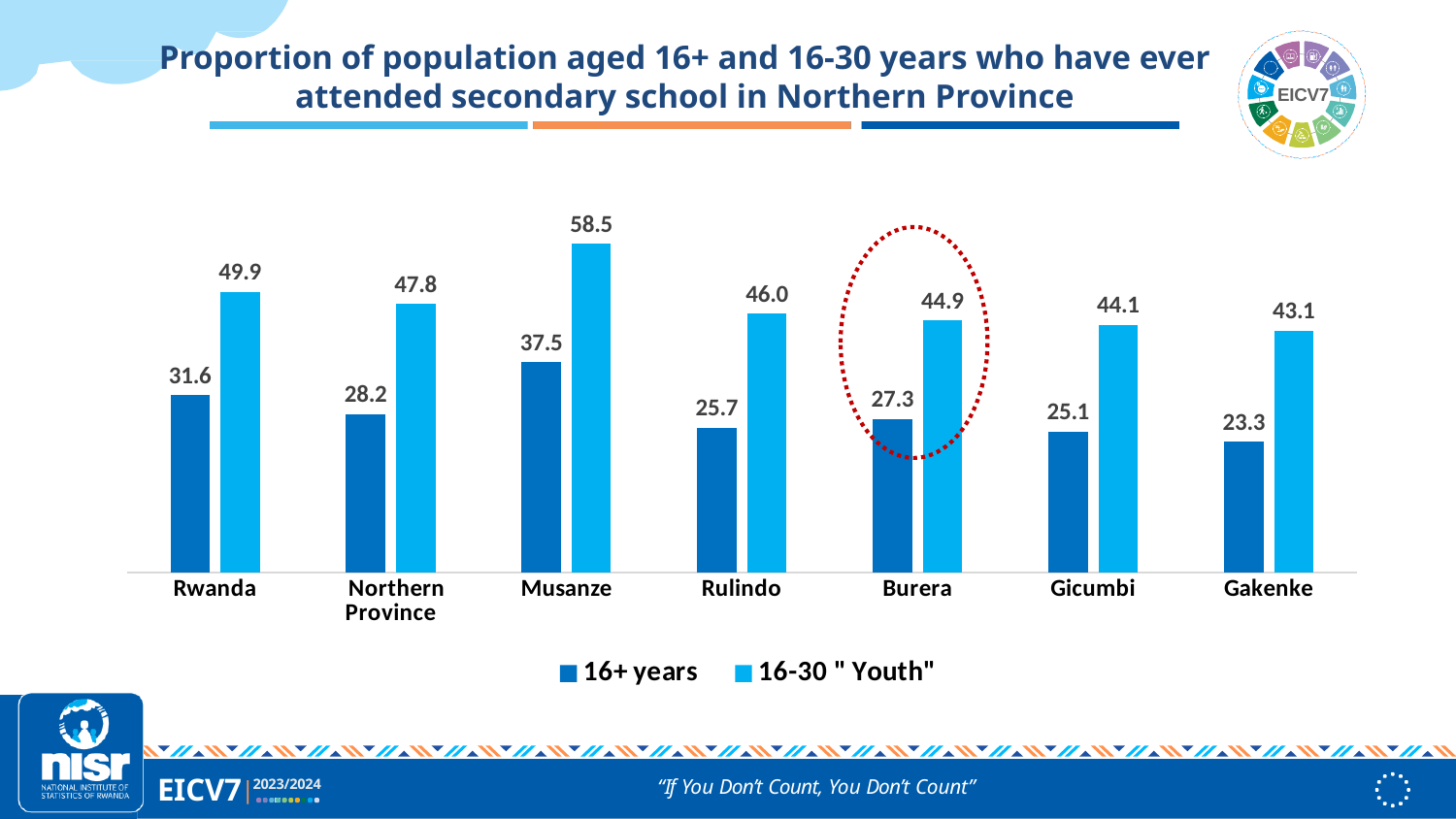
What is the value for the 16+ years series in Musanze? 37.5 What kind of chart is shown on the slide? Bar chart Which category has the lowest value for the 16+ years series? Gakenke What is the difference between the 16-30 "Youth" value and the 16+ years value in Musanze? 21.0 What is the value for the 16-30 "Youth" series in Burera? 44.9 How many categories are shown on the x axis? 7 What is the value for the 16+ years series for Rwanda? 31.6 Which is larger: the 16+ years value for Rulindo or for Burera? Burera What is the difference between the 16-30 "Youth" value for Northern Province and for Gakenke? 4.7 How many series does the legend list? 2 Which category has the highest value for the 16-30 "Youth" series? Musanze Which category is highlighted with a red dotted circle? Burera